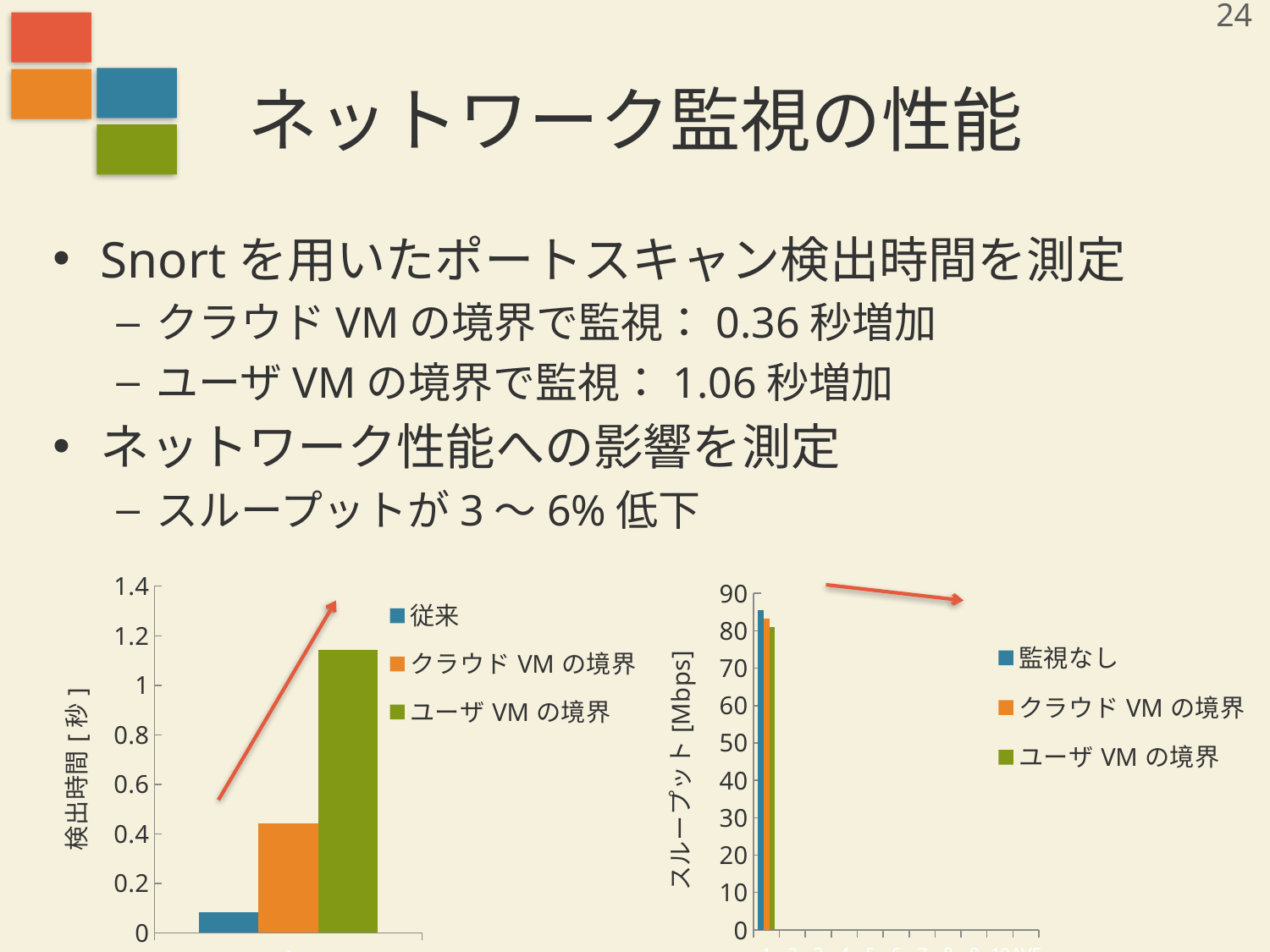
What is the y-axis label of the right chart? スループット [Mbps] How many series does the legend of the right chart (スループット) list? 3 In the left chart (検出時間), is the value for ユーザ VM の境界 greater or less than 1? greater In the left chart (検出時間), which is larger: the value for クラウド VM の境界 or the value for ユーザ VM の境界? ユーザ VM の境界 What kind of chart is the left chart (検出時間)? bar chart In the left chart (検出時間), is the value for 従来 greater or less than 0.2? less In the left chart (検出時間), is the value for クラウド VM の境界 greater or less than 0.6? less In the left chart (検出時間), which series has the lowest detection time? 従来 In the left chart (検出時間), which series has the highest detection time? ユーザ VM の境界 How many series does the legend of the left chart (検出時間) list? 3 What kind of chart is the right chart (スループット)? bar chart